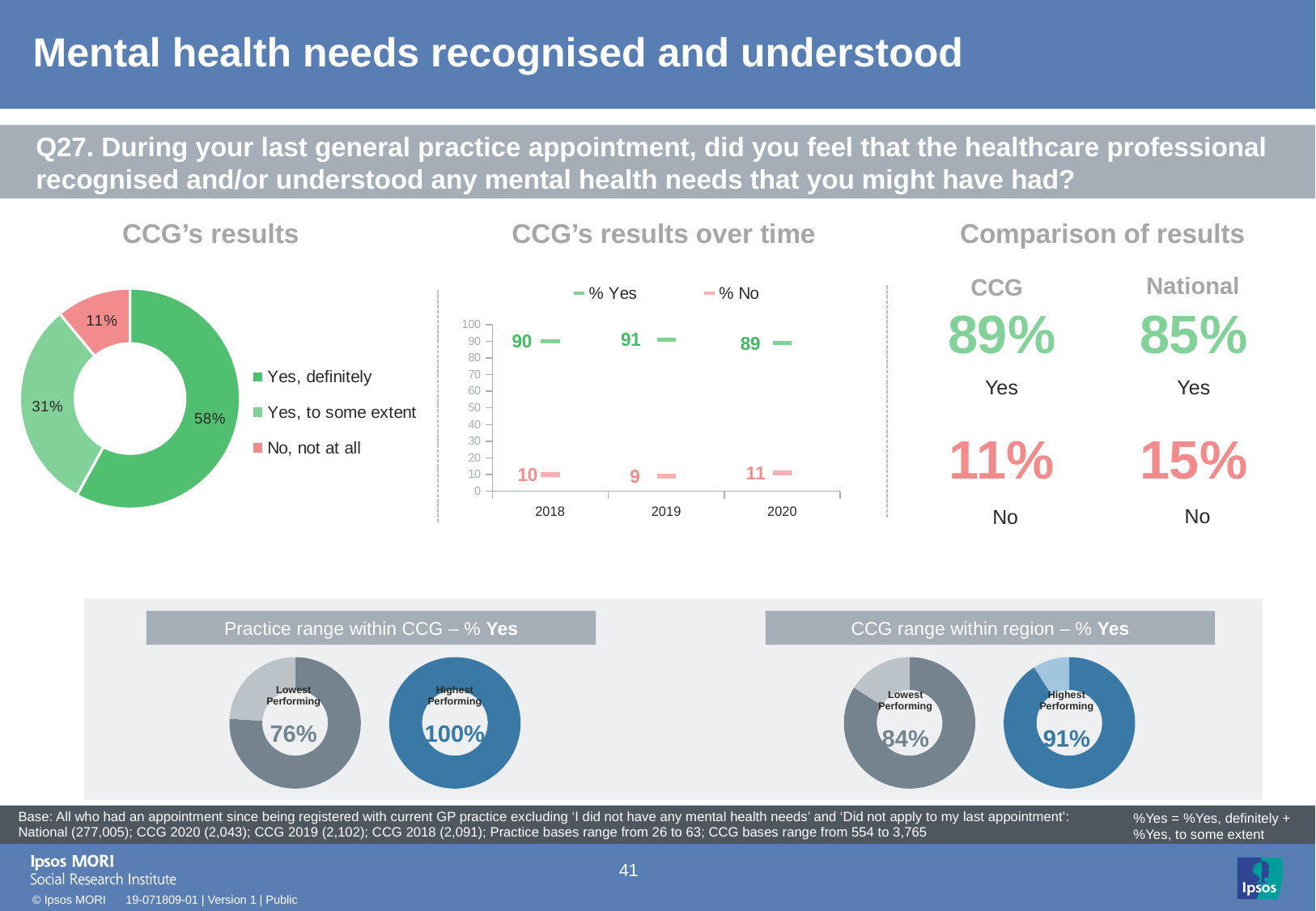
In the "CCG's results over time" chart, what is the % No value for 2020? 11 In the "CCG's results over time" chart, is the % Yes value for 2018 larger or smaller than the % Yes value for 2019? smaller In the "CCG's results" donut chart, how many response categories does the legend list? 3 In the "CCG's results over time" chart, which year has the lowest % No value? 2019 In the "CCG's results" donut chart, what percentage answered "Yes, definitely"? 58% In the "CCG's results over time" chart, how many series does the legend list? 2 In the "CCG's results" donut chart, what percentage answered "No, not at all"? 11% In the "CCG's results" donut chart, what is the difference between the "Yes, definitely" and "Yes, to some extent" shares? 27 percentage points In the "CCG's results" donut chart, which response category has the smallest share? No, not at all In the "CCG's results over time" chart, what is the % Yes value for 2019? 91 In the "Practice range within CCG – % Yes" section, what is the Highest Performing value? 100% In the "CCG's results over time" chart, how many years are plotted on the x axis? 3